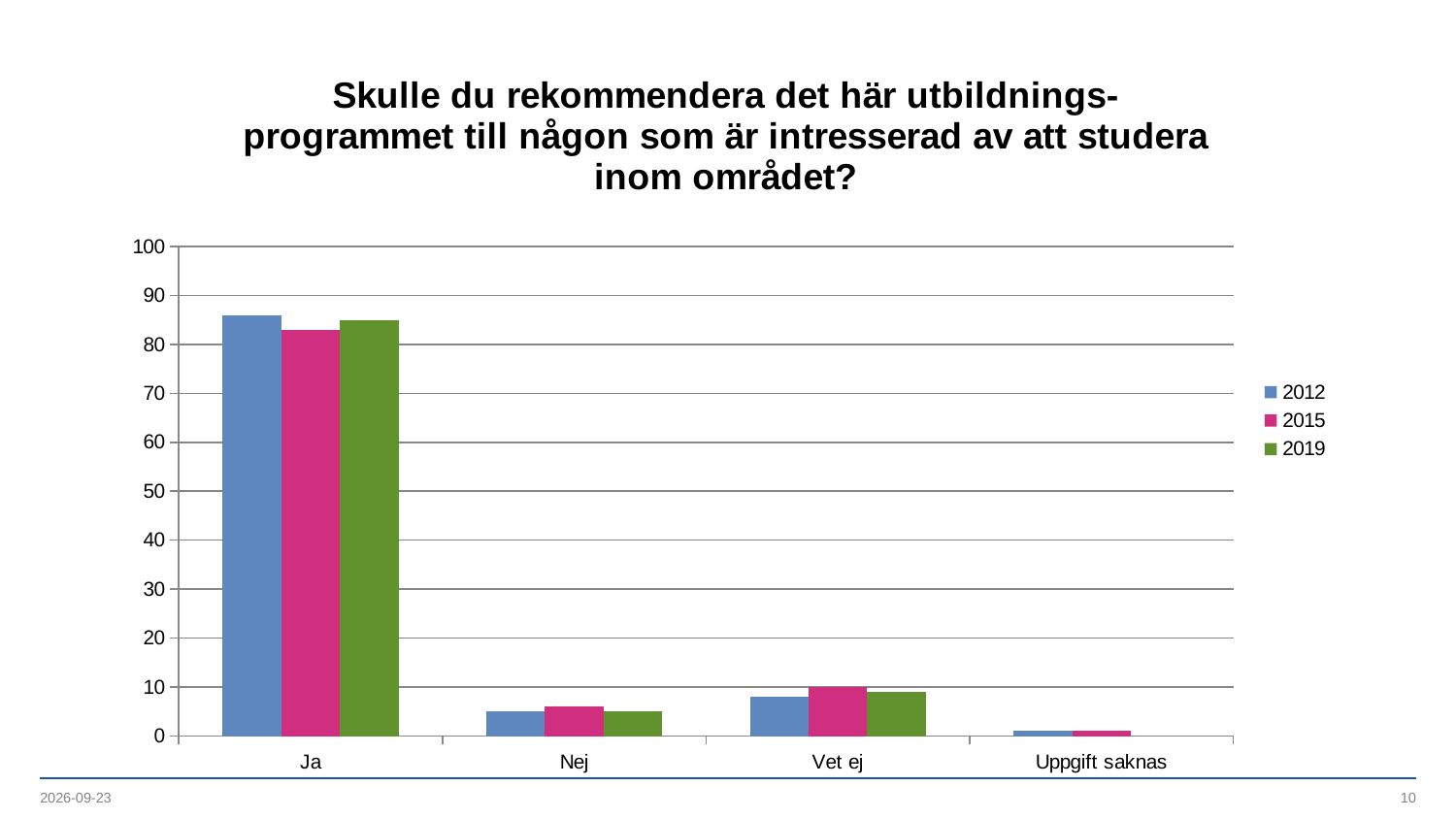
Is the value for Nej in 2015 greater or less than 10? less Is the value for Ja in 2012 greater or less than 80? greater Is the value for Ja in 2015 greater or less than 90? less How many series does the legend list? 3 Which series is shown in green in the legend? 2019 How many categories are shown on the x axis? 4 Which is larger for 2012: the value for Ja or the value for Nej? Ja What kind of chart is shown on the slide? bar chart Which category has the lowest values across all series? Uppgift saknas Which is larger for 2015: the value for Vet ej or the value for Nej? Vet ej Which category has the highest values across all series? Ja